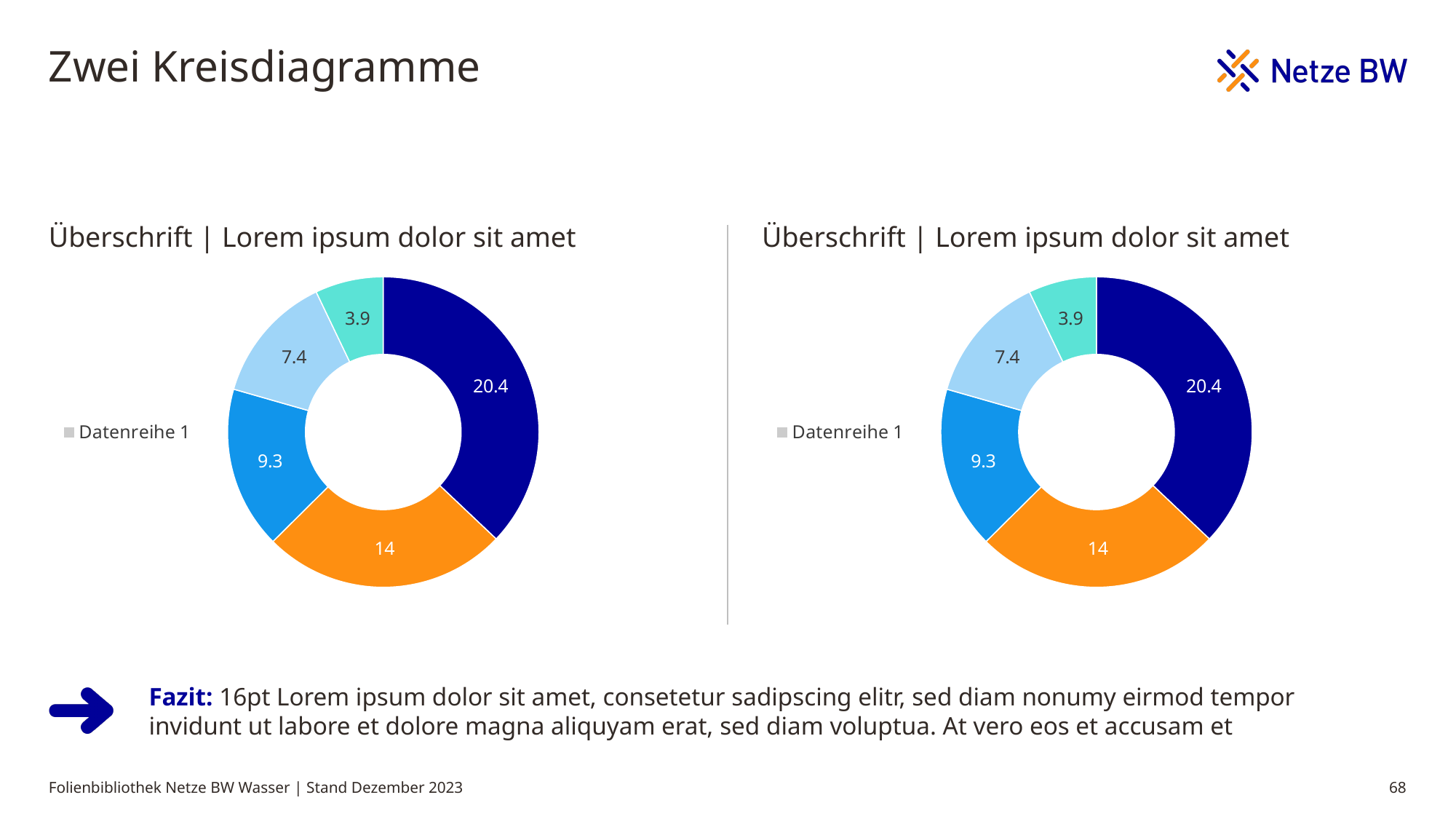
In the right chart, which slice is larger: the orange slice or the medium blue slice? the orange slice (14) What is the legend entry shown next to the left chart? Datenreihe 1 What is the total of all slice values in the left chart? 55 In the left chart, what is the value of the orange slice? 14 In the right chart, what is the value of the smallest slice? 3.9 In the right chart, what is the value of the light blue slice? 7.4 How many series does the legend of the right chart list? 1 In the left chart, what is the value of the largest slice? 20.4 In the left chart, what is the difference between the largest slice (20.4) and the orange slice (14)? 6.4 How many slices does the left chart have? 5 In the right chart, what is the difference between the medium blue slice (9.3) and the teal slice (3.9)? 5.4 What kind of chart is the left chart on the slide? doughnut (pie) chart